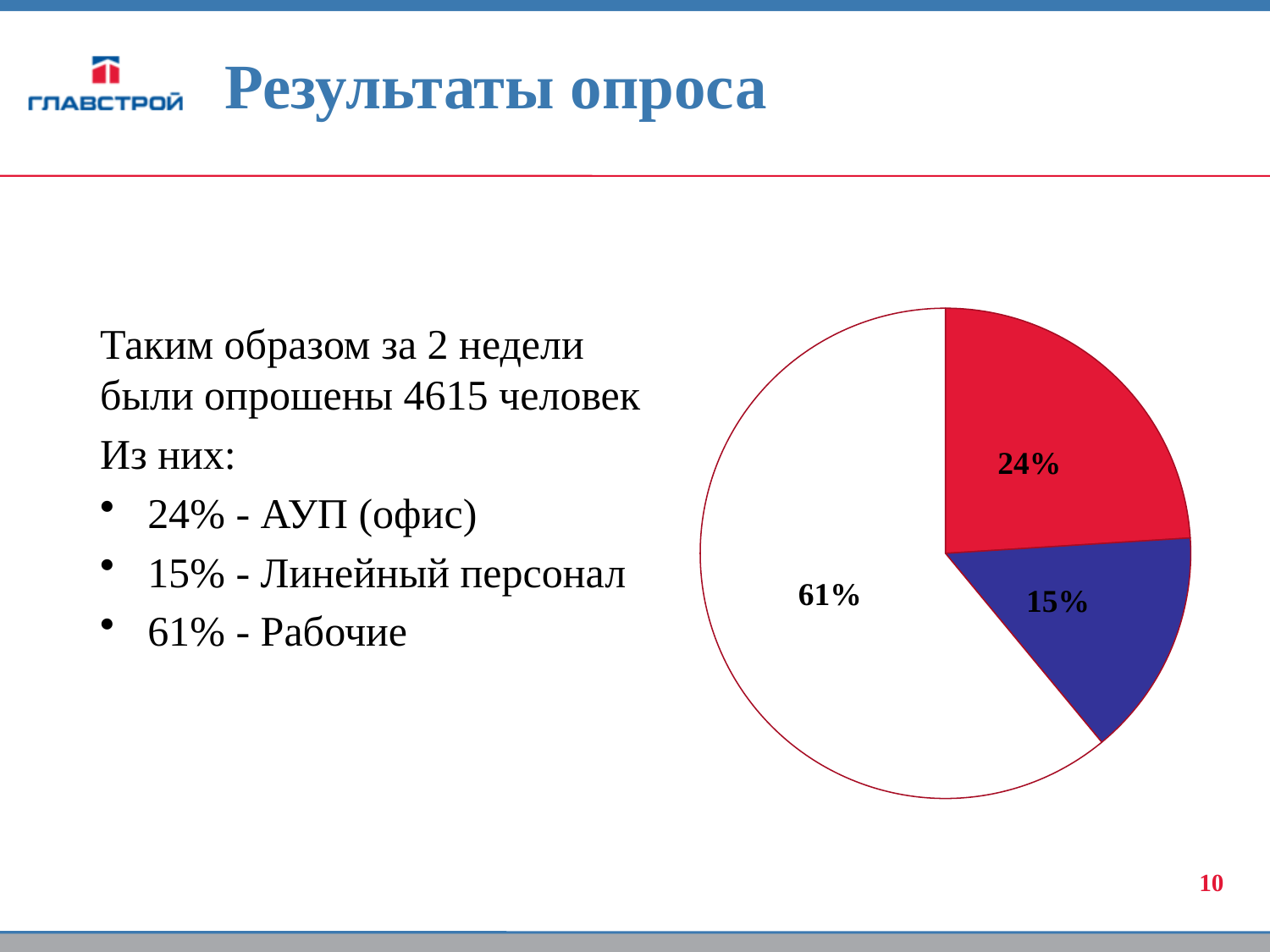
What is the difference between the red slice and the blue slice of the pie chart? 9% How many slices does the pie chart have? 3 Which slice of the pie chart is the smallest? 15% What kind of chart is shown on the slide? pie chart What percentage is shown on the white slice of the pie chart? 61% Which is larger in the pie chart, the red slice or the blue slice? the red slice What percentage is shown on the blue slice of the pie chart? 15% What percentage is shown on the red slice of the pie chart? 24% According to the slide text, what share of respondents were АУП (офис)? 24% Which slice of the pie chart is the largest? 61% What is the difference between the largest and smallest slices of the pie chart? 46% According to the slide text, which group does the 61% slice represent? Рабочие